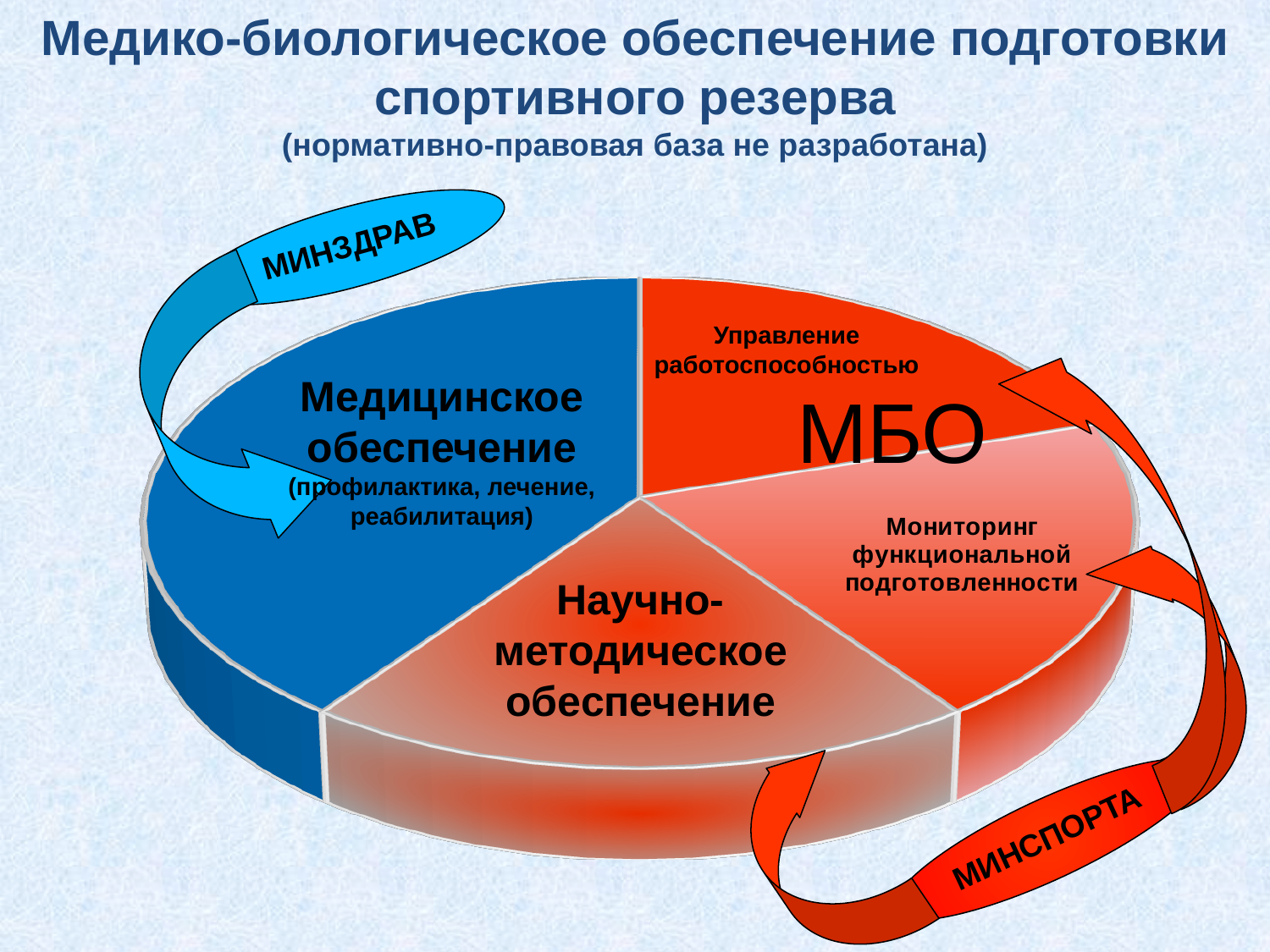
Which ministry is named on the blue arrow pointing to the pie chart? МИНЗДРАВ Which segment of the pie chart is the largest? Медицинское обеспечение How many segments does the pie chart have? 4 What kind of chart is shown on the slide? pie chart What colour is the segment labelled "Медицинское обеспечение"? blue